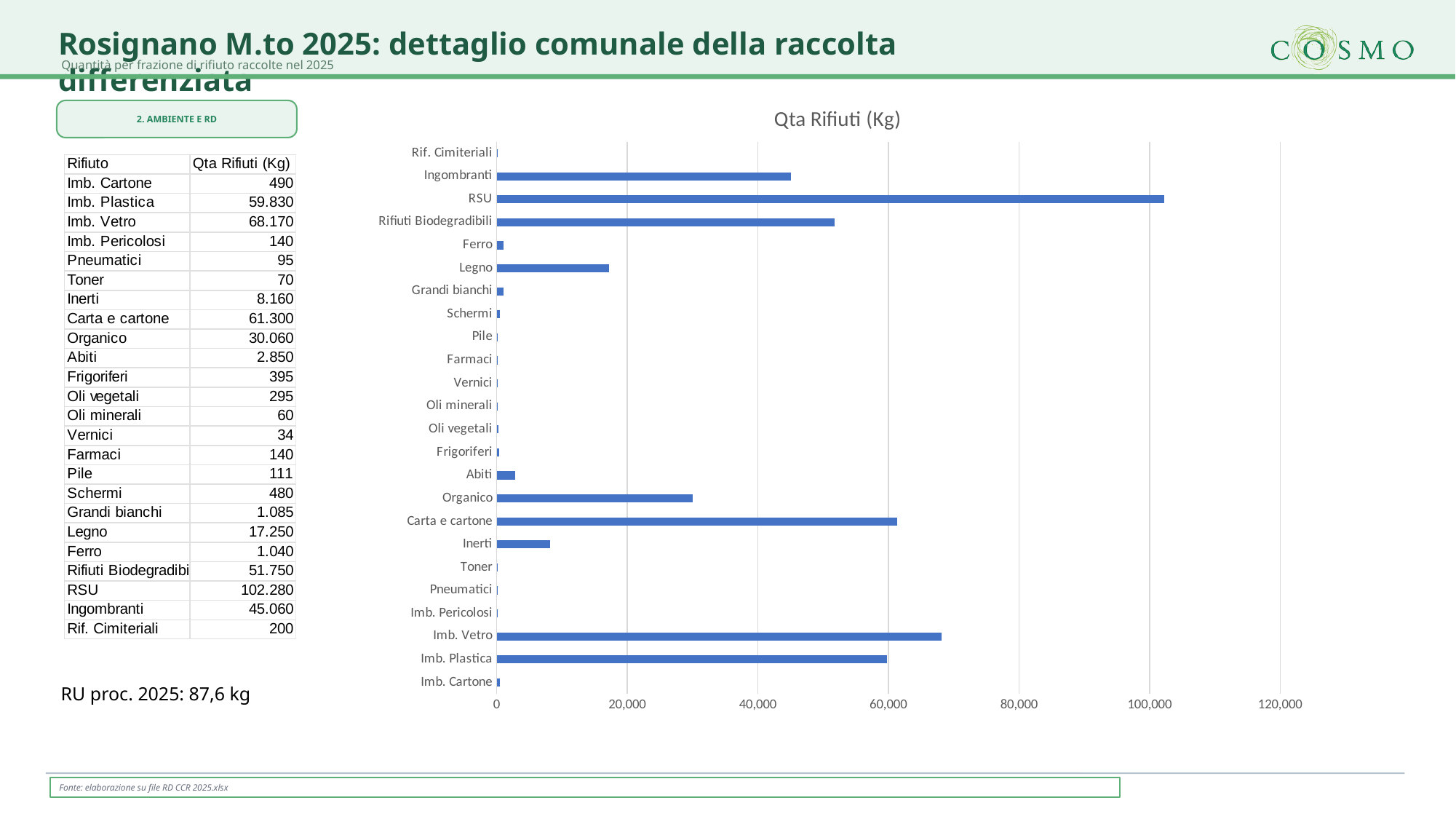
What is the title of the chart? Qta Rifiuti (Kg) What kind of chart is shown on the slide? bar chart What is the quantity for Ingombranti? 45.060 How many waste categories are plotted in the chart? 24 Which category has the lowest quantity? Vernici Which is larger, the quantity for Carta e cartone or for Organico? Carta e cartone Is the value for RSU greater or less than 100,000? greater What is the quantity for RSU? 102.280 Which category has the highest quantity in the chart? RSU Is the value for Legno greater or less than 20,000? less What is the quantity for Imb. Vetro? 68.170 What is the difference between the quantities for Imb. Vetro and Imb. Plastica? 8.340